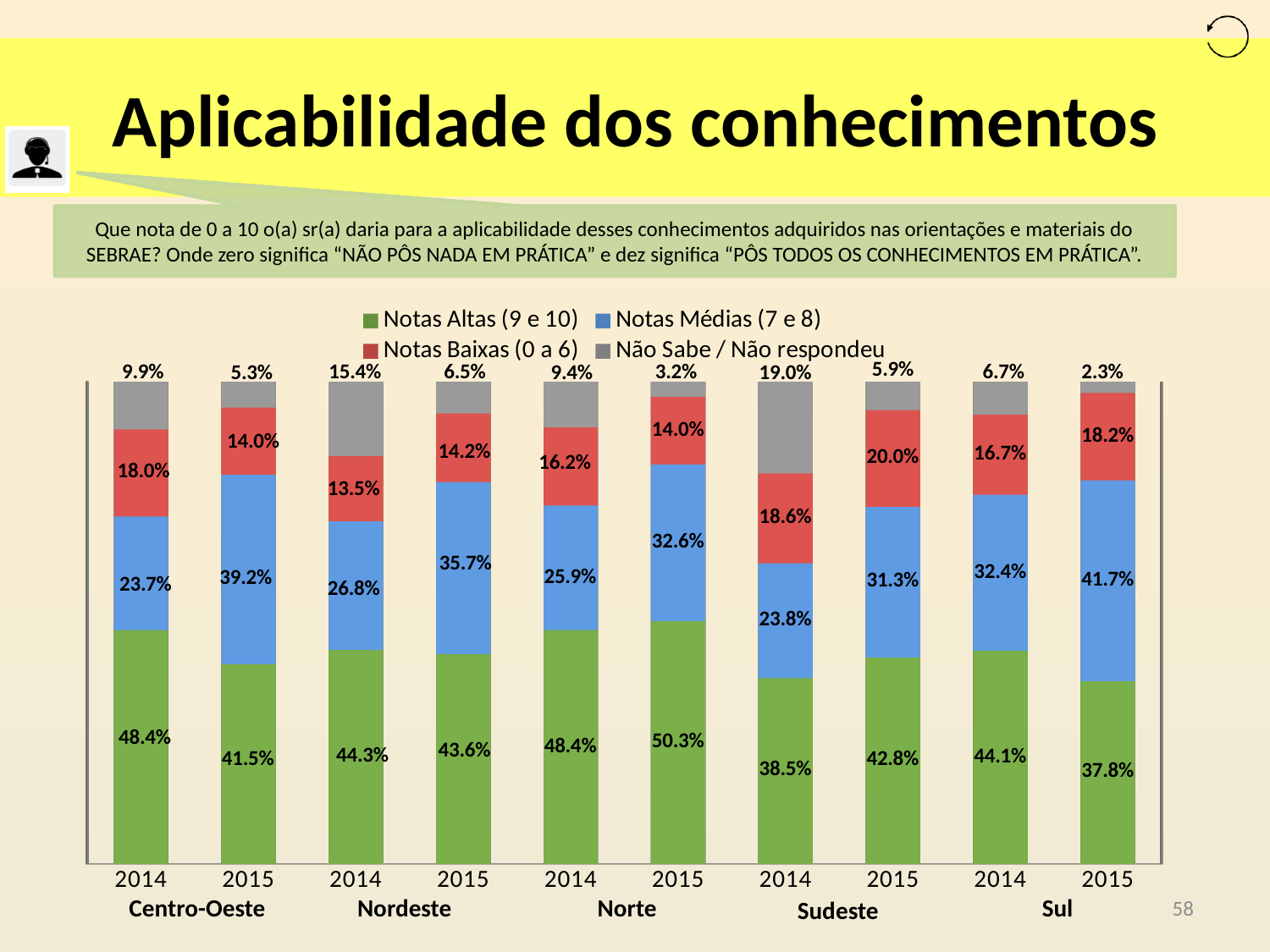
What is the value of Notas Baixas (0 a 6) for Nordeste in 2014? 13.5% What is the value of Notas Médias (7 e 8) for Sul in 2015? 41.7% Which is larger: Notas Baixas (0 a 6) for Sudeste 2015 or for Centro-Oeste 2014? Sudeste 2015 (20.0%) What is the value of Notas Altas (9 e 10) for Centro-Oeste in 2014? 48.4% What is the difference between the Notas Médias (7 e 8) values for Sul in 2015 and Sul in 2014? 9.3 percentage points How many series does the legend list? 4 Did the Notas Altas (9 e 10) value for Sul rise or fall from 2014 to 2015? Fall Which bar has the lowest value for Não Sabe / Não respondeu? Sul 2015 (2.3%) What kind of chart is shown on the slide? Stacked bar chart Which bar has the highest value for Notas Altas (9 e 10)? Norte 2015 (50.3%) How many bars are plotted in the chart? 10 What is the value of Não Sabe / Não respondeu for Sudeste in 2014? 19.0%